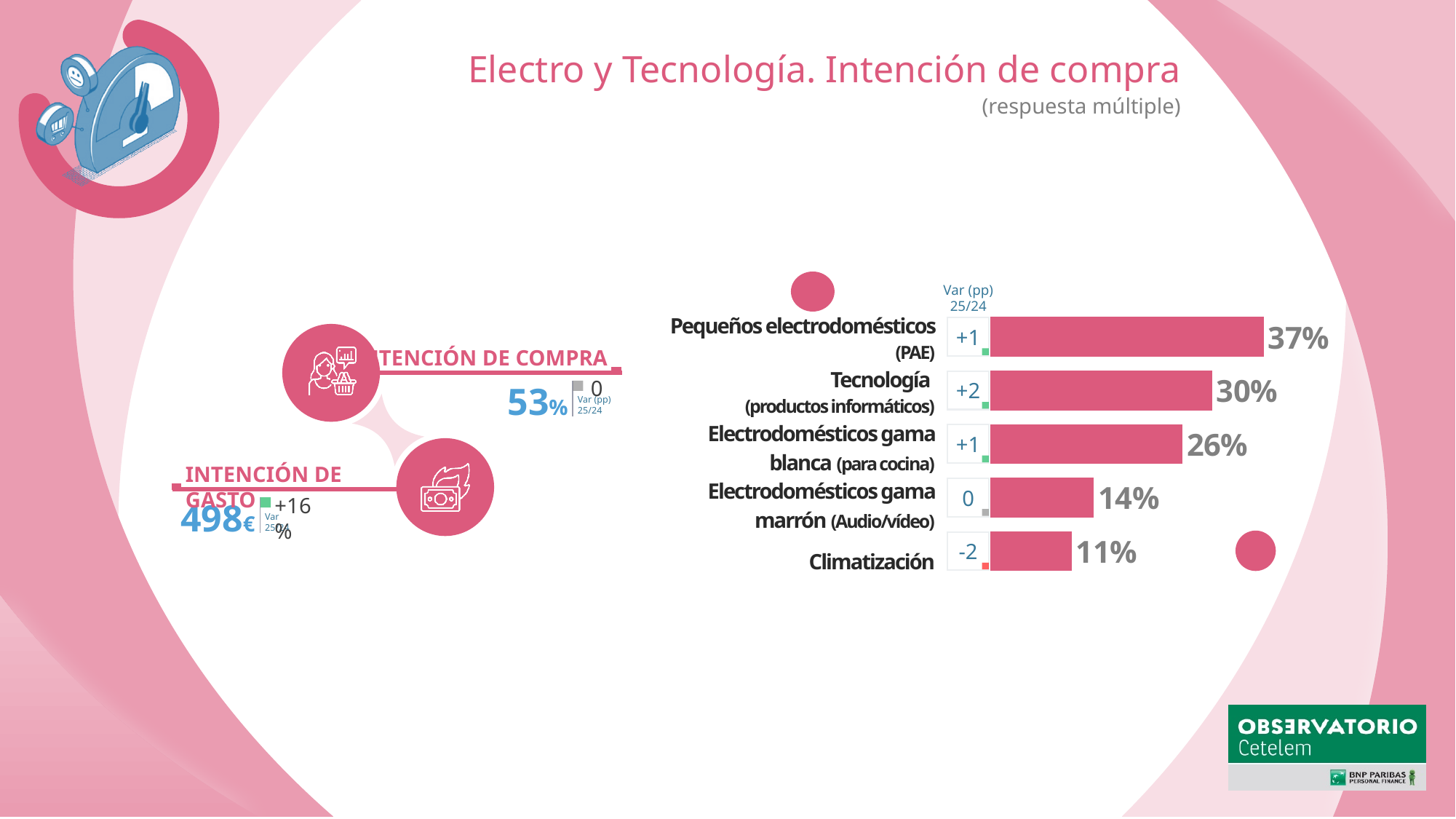
What is the Var (pp) 25/24 shown for Tecnología (productos informáticos)? +2 What is the difference between Pequeños electrodomésticos (PAE) and Tecnología (productos informáticos)? 7 percentage points How many categories are shown in the bar chart? 5 Which is larger: Electrodomésticos gama blanca (para cocina) or Electrodomésticos gama marrón (Audio/vídeo)? Electrodomésticos gama blanca (para cocina) What is the value for Pequeños electrodomésticos (PAE)? 37% Which category has the highest value? Pequeños electrodomésticos (PAE) What is the Var (pp) 25/24 shown for Climatización? -2 Which category has the lowest value? Climatización What is the value for Tecnología (productos informáticos)? 30% What kind of chart is shown on the slide? Bar chart What is the value for Climatización? 11% What is the value for Electrodomésticos gama blanca (para cocina)? 26%